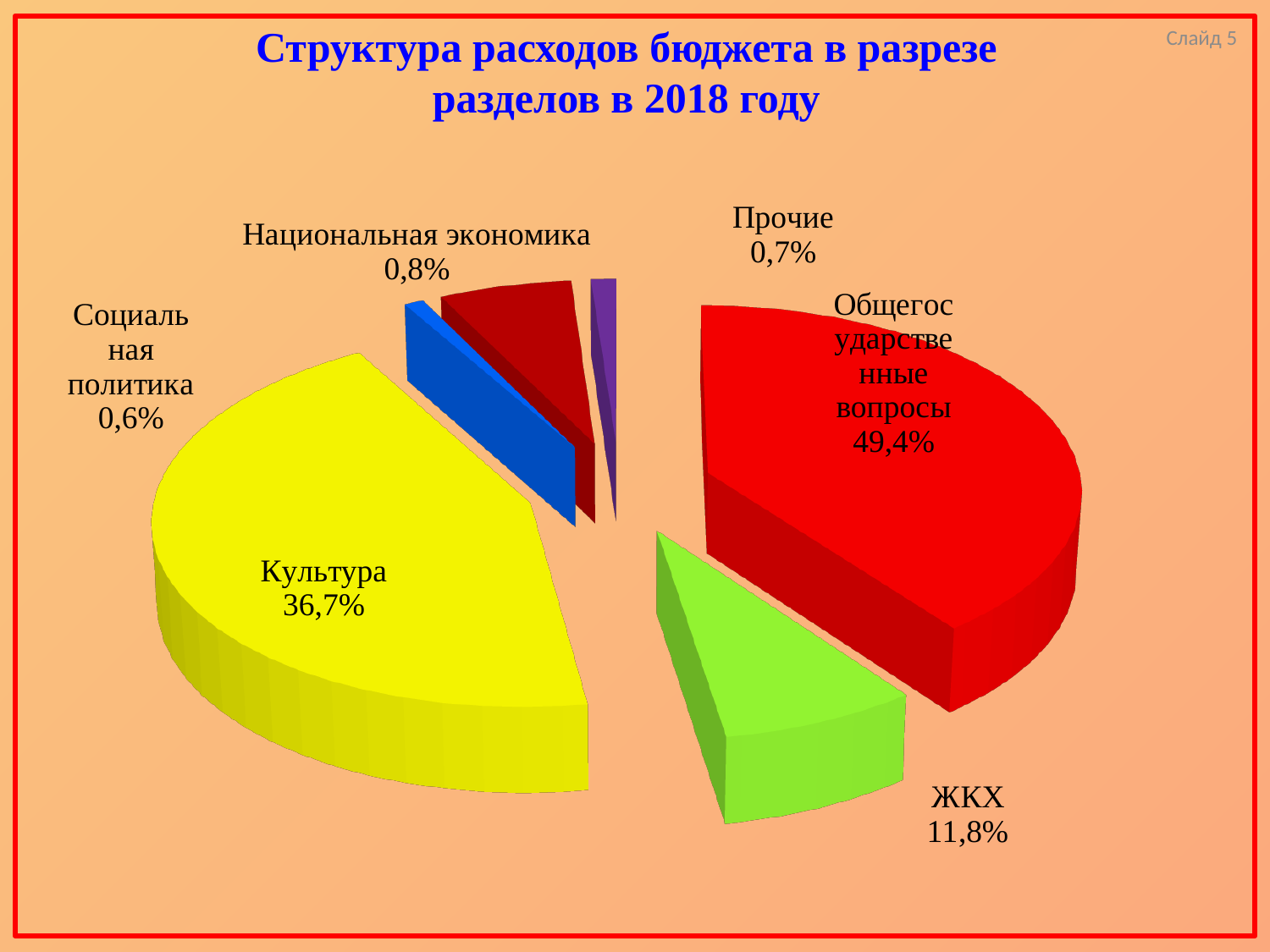
What share is shown for ЖКХ? 11,8% By how many percentage points does the share for Общегосударственные вопросы exceed the share for Культура? 12,7% What is the title of the chart? Структура расходов бюджета в разрезе разделов в 2018 году What kind of chart is shown on the slide? pie chart What share is shown for Социальная политика? 0,6% What share is shown for Национальная экономика? 0,8% Which is larger, the share for Культура or the share for ЖКХ? Культура How many slices does the pie chart have? 6 Which section has the smallest share of budget expenditure? Социальная политика Which section has the largest share of budget expenditure? Общегосударственные вопросы What share is shown for Культура? 36,7% What share of budget expenditure is labelled for Общегосударственные вопросы? 49,4%